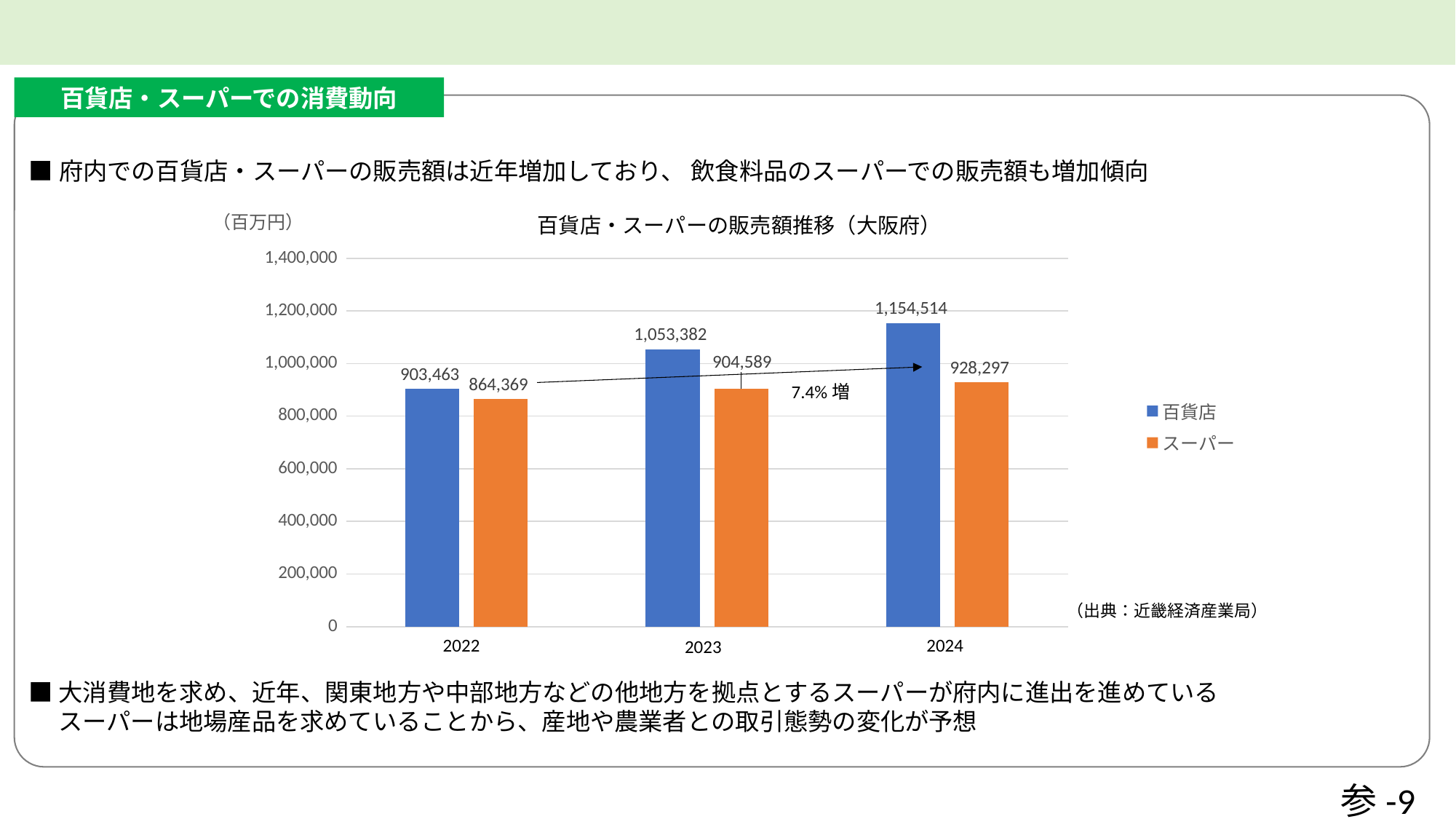
In which year is the スーパー value lowest? 2022 What is the value for 百貨店 in 2022? 903,463 In which year is the 百貨店 value highest? 2024 What kind of chart is shown? bar chart What is the value for スーパー in 2024? 928,297 What is the value for スーパー in 2023? 904,589 What is the difference between the 百貨店 and スーパー values in 2024? 226,217 What is the difference between the 百貨店 values in 2023 and 2022? 149,919 Which is larger in 2023, 百貨店 or スーパー? 百貨店 Is the value for 百貨店 in 2024 greater or less than 1,000,000? greater How many series does the legend list? 2 How many years are shown on the x axis? 3